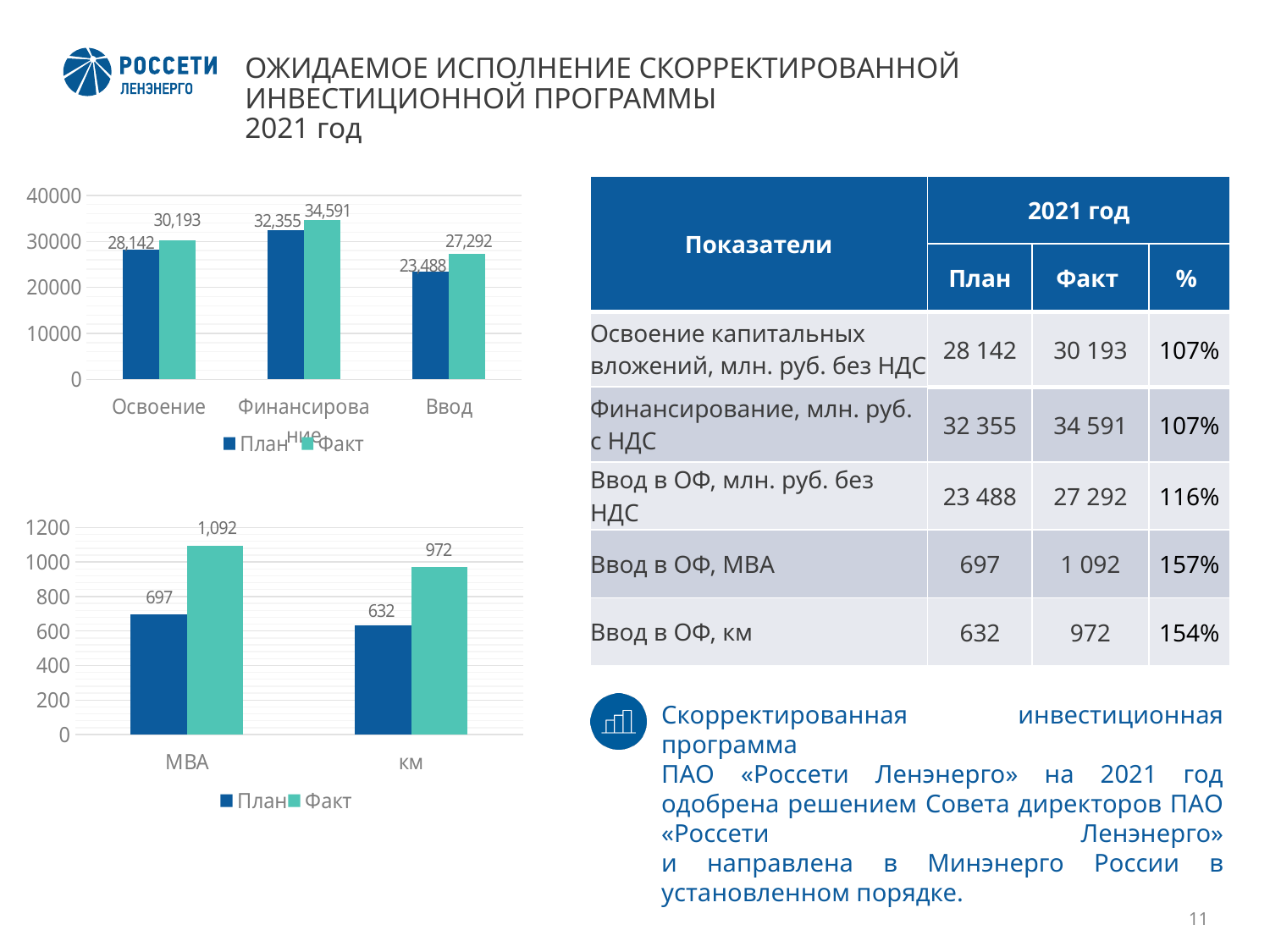
In the top chart on the left, what is the План value for Освоение? 28,142 In the bottom chart on the left, what is the difference between the Факт and План values for МВА? 395 In the bottom chart on the left, what is the Факт value for МВА? 1,092 In the top chart on the left, how many categories are shown on the x axis? 3 In the bottom chart on the left, how many series does the legend list? 2 In the top chart on the left, what is the Факт value for Финансирование? 34,591 What type of chart is the bottom chart on the left? Bar chart In the top chart on the left, what is the difference between the Факт and План values for Ввод? 3,804 In the top chart on the left, which category has the lowest План value? Ввод In the bottom chart on the left, what is the План value for км? 632 In the bottom chart on the left, which is larger for км: План or Факт? Факт In the top chart on the left, which category has the highest Факт value? Финансирование